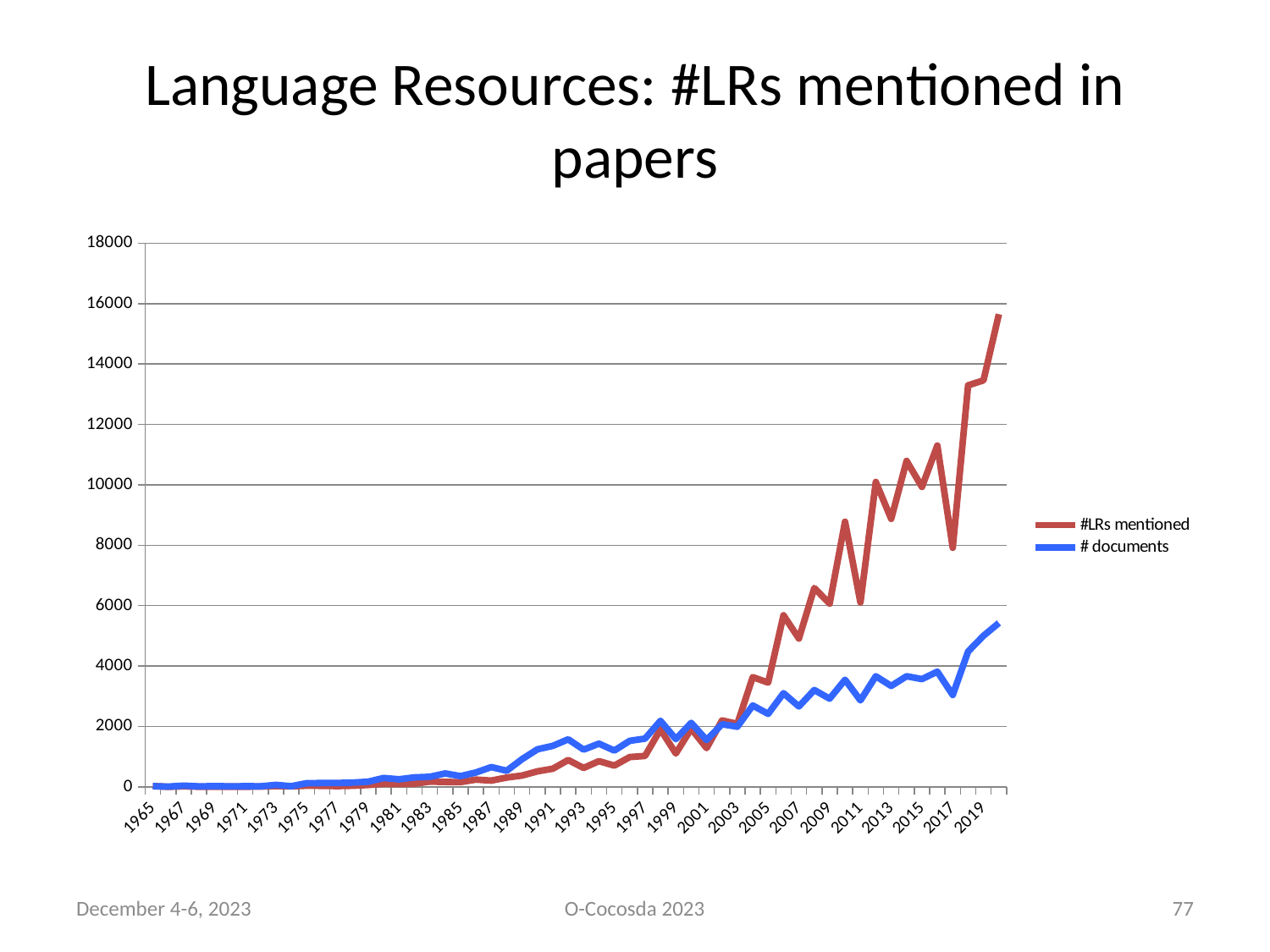
Is the value for #LRs mentioned in 2019 greater or less than 12000? greater In 2011, which series has the higher value, #LRs mentioned or # documents? #LRs mentioned Is the value for # documents in 2017 greater or less than 4000? less Is the value for #LRs mentioned in 2005 greater or less than 2000? greater Which series reaches the highest value on the chart? #LRs mentioned Does the #LRs mentioned series generally rise or fall from 1965 to 2019? rise What colour is the line for # documents? blue In 1991, which series has the higher value, #LRs mentioned or # documents? # documents How many series does the legend list? 2 What are the two series named in the legend? #LRs mentioned and # documents What kind of chart is shown on the slide? line chart